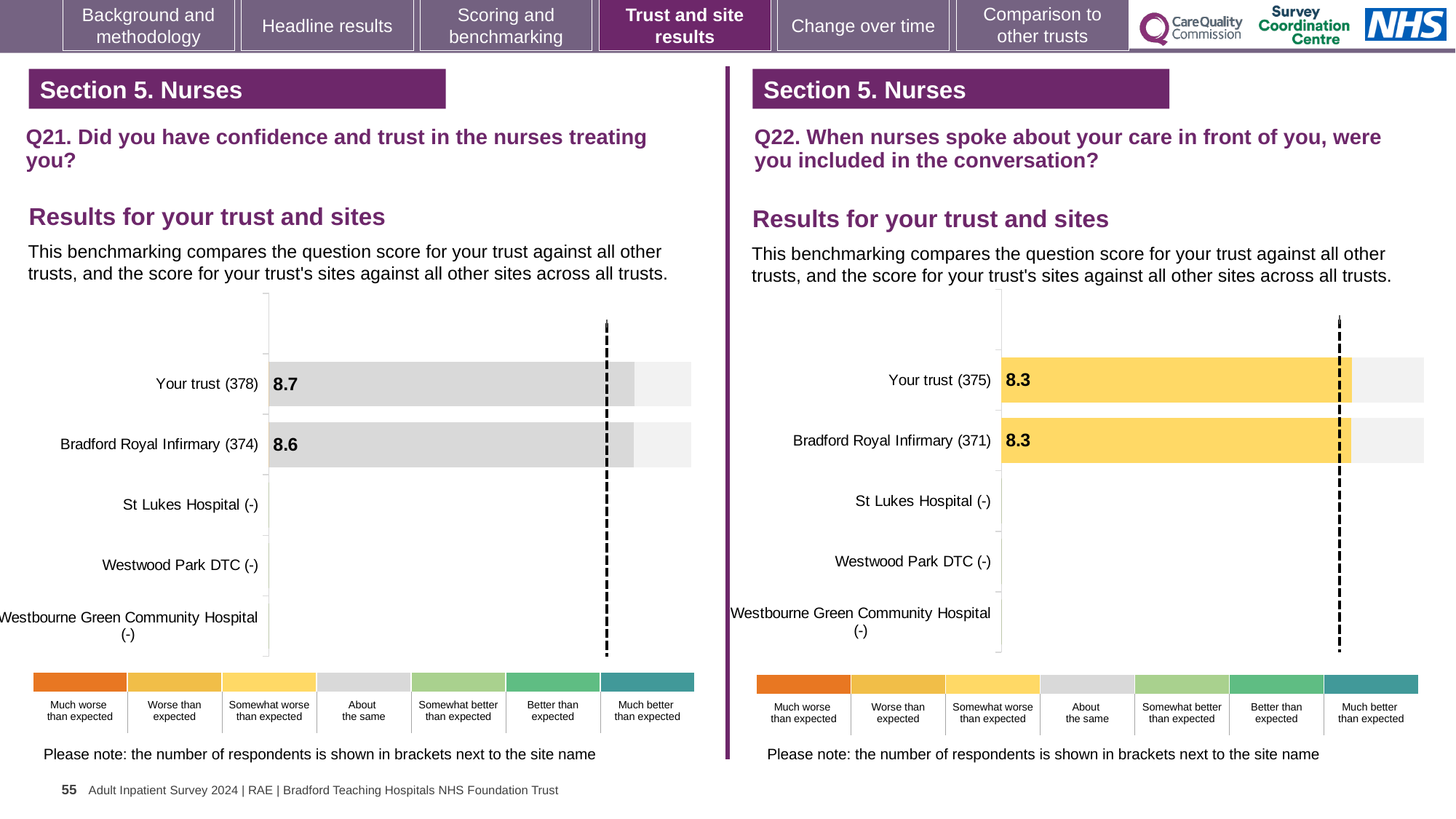
In the Q22 chart on the right, what is the score for Your trust (375)? 8.3 In the Q21 chart on the left, which benchmark category does the colour of the Your trust bar correspond to in the legend? About the same In the Q21 chart on the left, how many respondents are shown in brackets for Bradford Royal Infirmary? 374 In the Q21 chart on the left, what is the score for Your trust (378)? 8.7 In the Q21 chart on the left, what is the difference between the score for Your trust and the score for Bradford Royal Infirmary? 0.1 In the Q22 chart on the right, what is the score for Bradford Royal Infirmary (371)? 8.3 In the Q21 chart on the left, which has the higher score, Your trust or Bradford Royal Infirmary? Your trust In the Q22 chart on the right, which benchmark category does the colour of the Your trust bar correspond to in the legend? Somewhat worse than expected In the Q21 chart on the left, what is the score for Bradford Royal Infirmary (374)? 8.6 What type of chart is used for the Q22 results on the right? Bar chart In the Q22 chart on the right, what is the difference between the score for Your trust and the score for Bradford Royal Infirmary? 0 How many site/trust categories are listed on the y axis of the Q21 chart on the left? 5